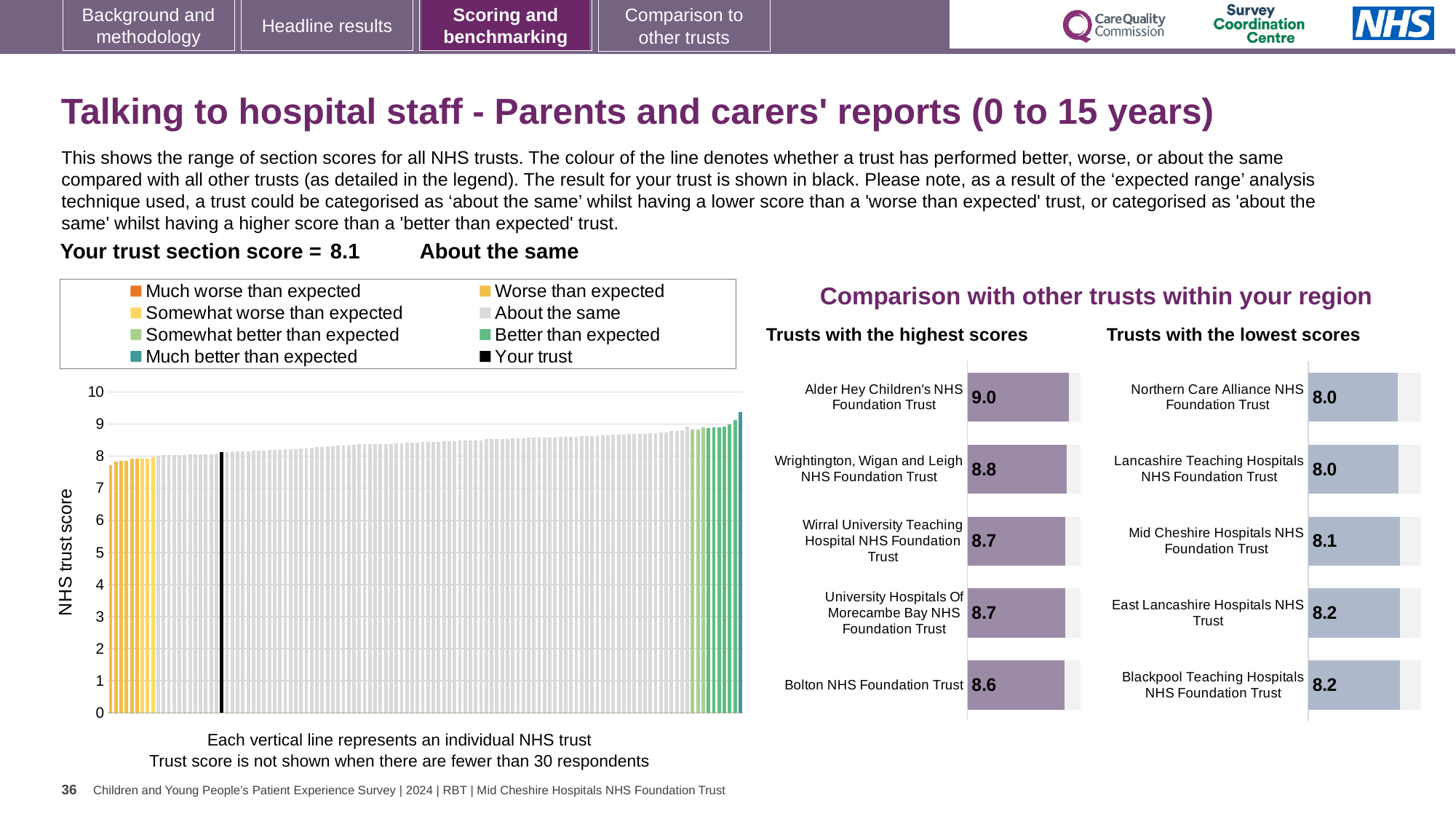
In the 'Trusts with the highest scores' chart, which has the higher score: Wrightington, Wigan and Leigh NHS Foundation Trust or Wirral University Teaching Hospital NHS Foundation Trust? Wrightington, Wigan and Leigh NHS Foundation Trust What is the y-axis label of the large chart on the left? NHS trust score In the 'Trusts with the highest scores' chart, what is the difference between the scores of Alder Hey Children's NHS Foundation Trust and Bolton NHS Foundation Trust? 0.4 What kind of chart is the large chart on the left showing NHS trust scores? Bar chart In the 'Trusts with the highest scores' chart, what is the score for Bolton NHS Foundation Trust? 8.6 How many entries does the legend of the large chart on the left list? 8 How many trusts are shown in the 'Trusts with the lowest scores' chart? 5 In the 'Trusts with the lowest scores' chart, what is the score for Mid Cheshire Hospitals NHS Foundation Trust? 8.1 In the 'Trusts with the highest scores' chart, which trust has the highest score? Alder Hey Children's NHS Foundation Trust In the large chart on the left, is the value for the black 'Your trust' bar greater or less than 5? greater In the 'Trusts with the lowest scores' chart, what is the score for East Lancashire Hospitals NHS Trust? 8.2 In the 'Trusts with the highest scores' chart, what is the score for Alder Hey Children's NHS Foundation Trust? 9.0